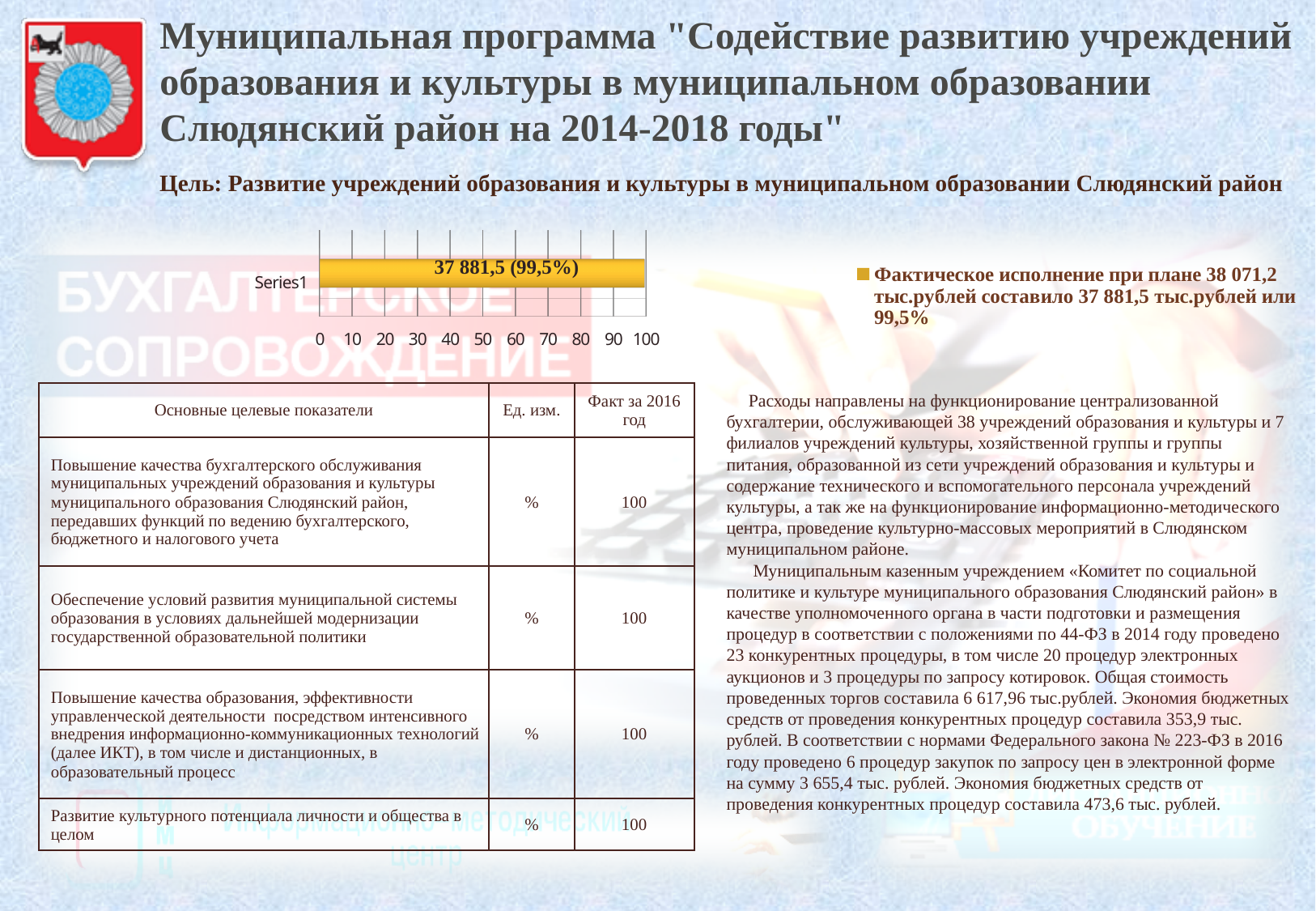
What is the category label shown next to the bar? Series1 According to the legend, what was the planned amount (план) in thousand rubles? 38 071,2 тыс.рублей What is the highest tick value shown on the chart's horizontal axis? 100 Is the value for Series1 greater or less than 50 on the axis? greater Is the value for Series1 greater or less than 90 on the axis? greater What percentage is shown in parentheses in the bar's data label? 99,5% What data label is printed on the bar for Series1? 37 881,5 (99,5%) What kind of chart is shown on the slide? bar chart How many series does the chart's legend list? 1 How many bars does the chart contain? 1